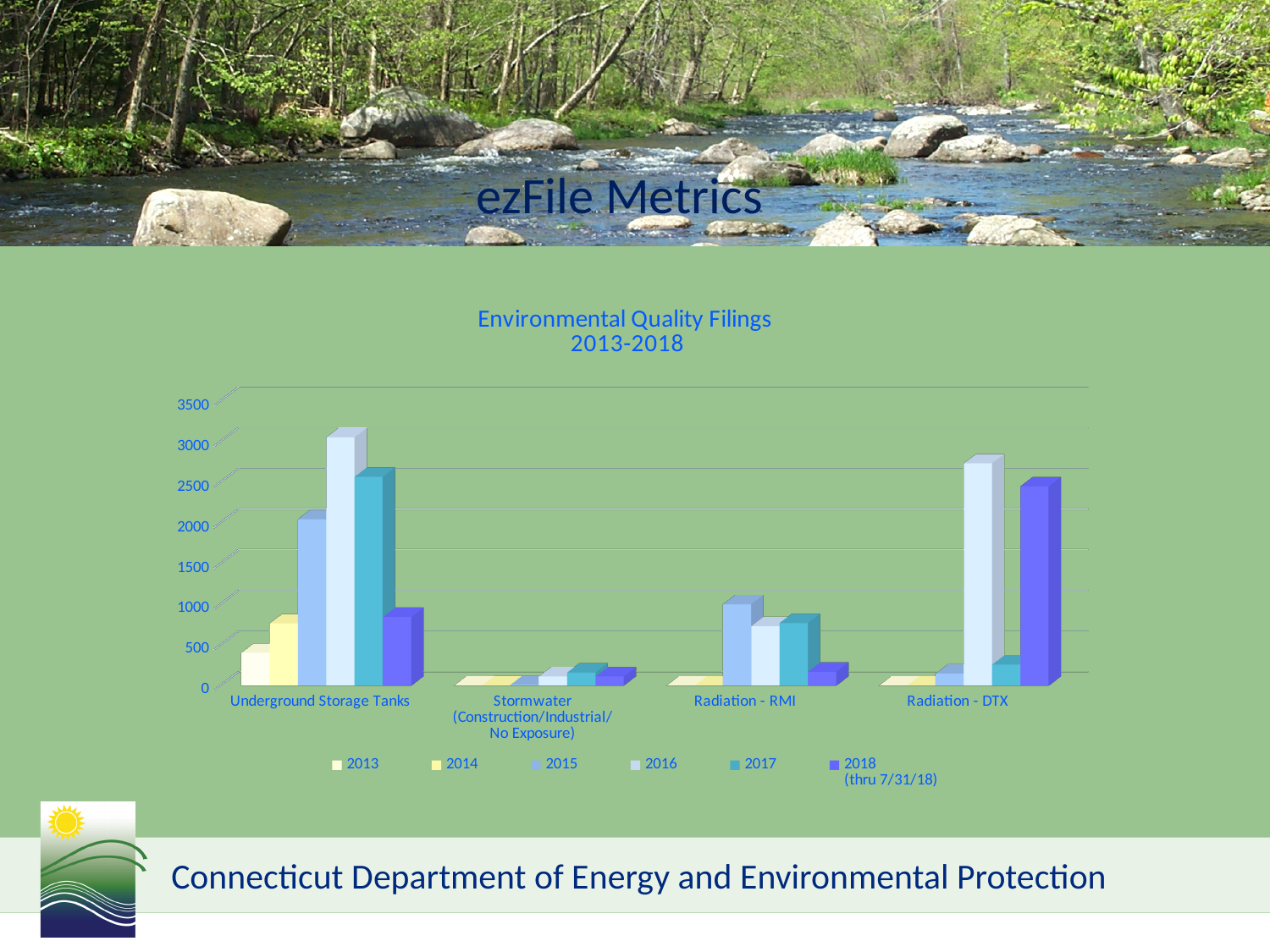
Is the 2016 value for Underground Storage Tanks greater or less than 2500? greater Is the 2017 value for Stormwater (Construction/Industrial/No Exposure) greater or less than 500? less Which category has the highest value for the 2016 series? Underground Storage Tanks How many categories are shown on the x axis of the chart? 4 Is the 2018 value for Radiation - DTX greater or less than 2000? greater What type of chart is shown on the slide? Bar chart In the Underground Storage Tanks category, which is larger: the 2015 value or the 2017 value? 2017 Which year has the highest value in the Underground Storage Tanks category? 2016 What is the title of the chart? Environmental Quality Filings 2013-2018 Which category has the lowest values overall across all years? Stormwater (Construction/Industrial/No Exposure) How many series does the chart's legend list? 6